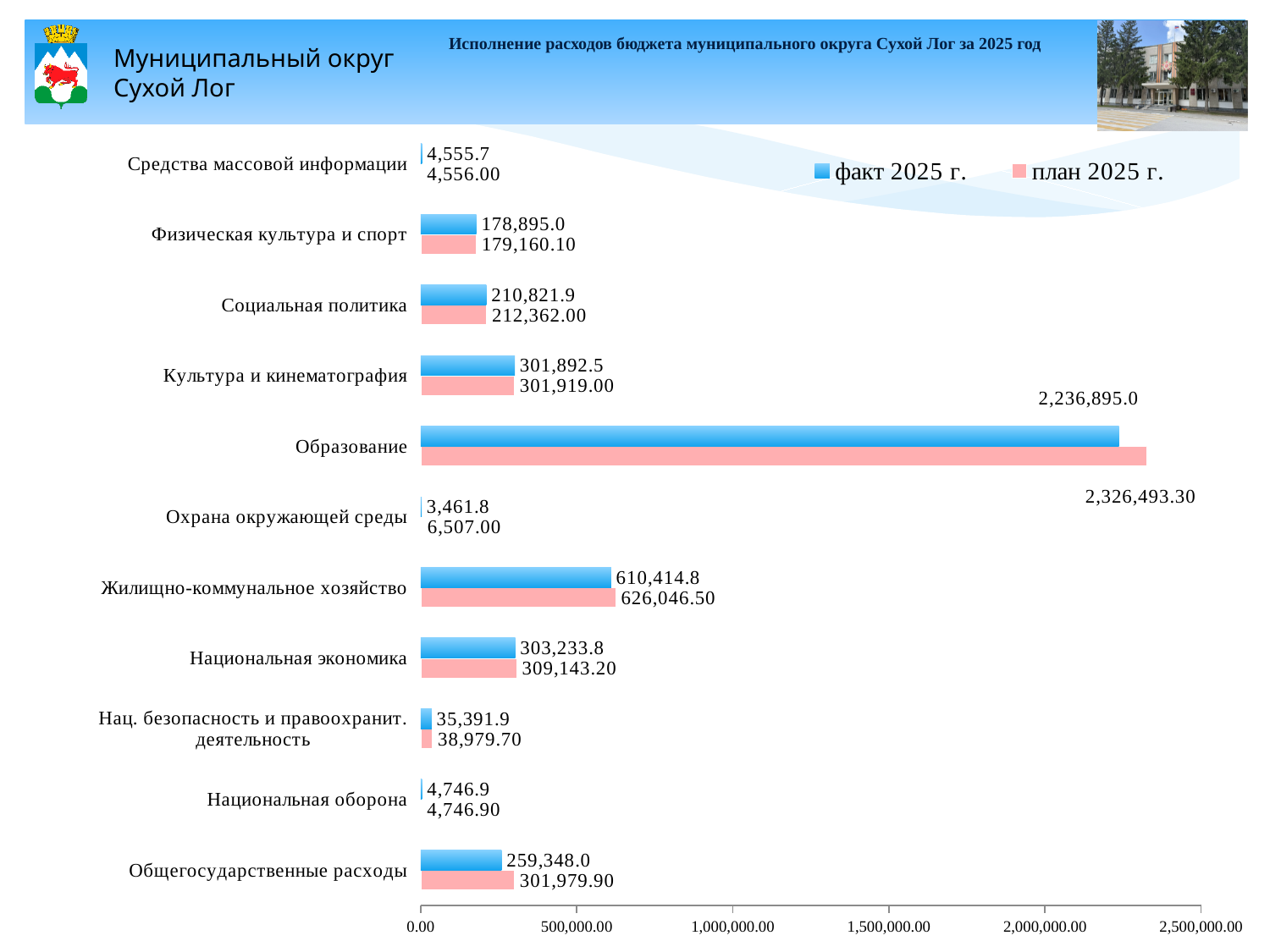
Which category has the highest план 2025 г. value? Образование What is the difference between the план 2025 г. and факт 2025 г. values for Общегосударственные расходы? 42,631.90 Is the факт 2025 г. value for Образование greater or less than 2,000,000.00? greater What is the факт 2025 г. value for Образование? 2,236,895.0 Which category has the lowest факт 2025 г. value? Охрана окружающей среды What kind of chart is shown on the slide? bar chart How many series does the legend list? 2 How many categories are shown on the chart? 11 Which is larger, the факт 2025 г. value for Жилищно-коммунальное хозяйство or the факт 2025 г. value for Национальная экономика? Жилищно-коммунальное хозяйство What is the difference between the план 2025 г. and факт 2025 г. values for Образование? 89,598.30 What is the факт 2025 г. value for Нац. безопасность и правоохранит. деятельность? 35,391.9 What is the план 2025 г. value for Жилищно-коммунальное хозяйство? 626,046.50